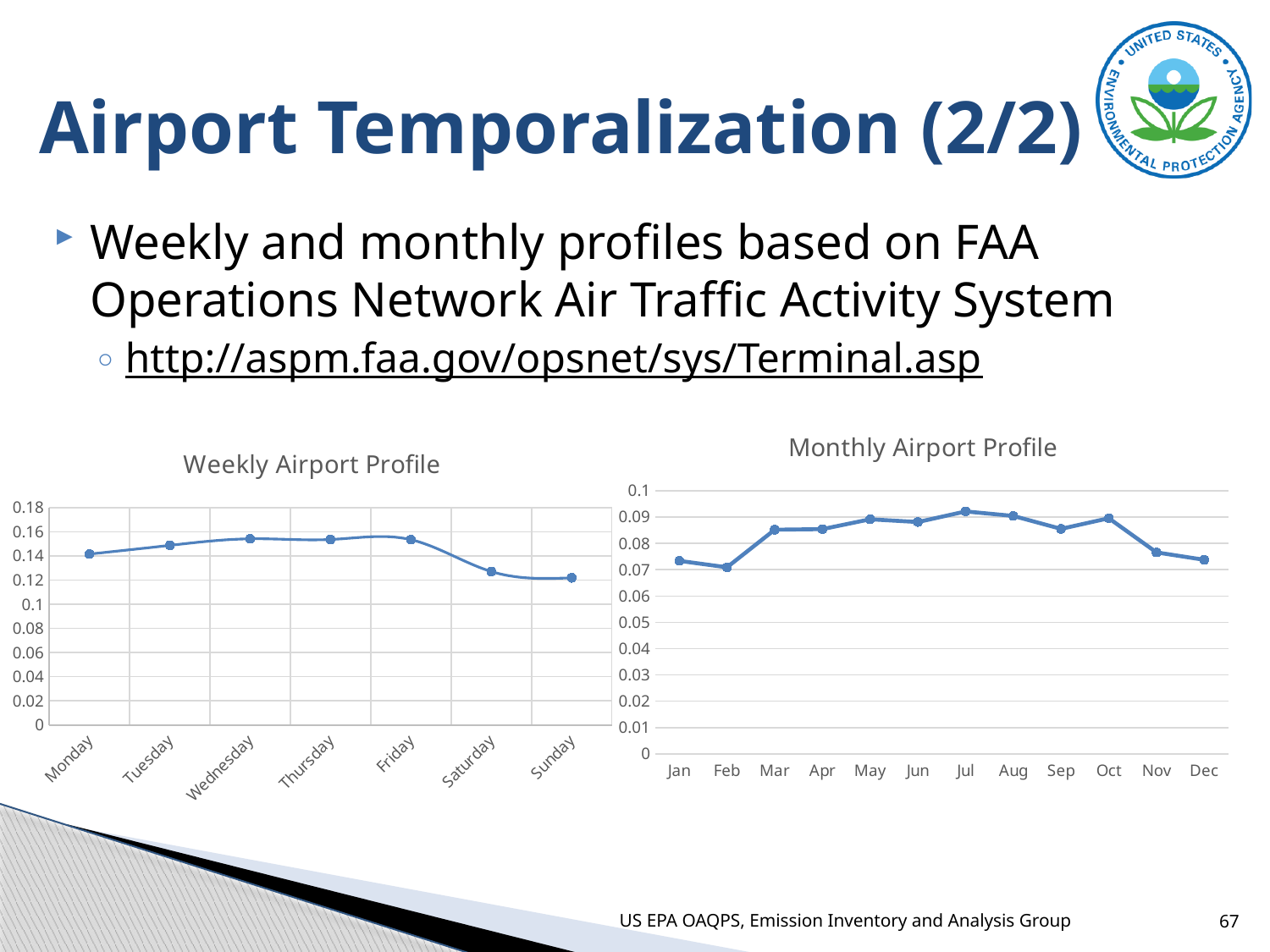
In the Weekly Airport Profile chart, how many days are plotted on the x axis? 7 In the Monthly Airport Profile chart, which is larger, the value for Jul or the value for Feb? Jul In the Monthly Airport Profile chart, which month has the lowest value? Feb What type of chart is the Weekly Airport Profile? line chart In the Monthly Airport Profile chart, is the value for Feb greater or less than 0.08? less In the Weekly Airport Profile chart, is the value for Sunday greater or less than 0.14? less What type of chart is the Monthly Airport Profile? line chart In the Weekly Airport Profile chart, do the values rise or fall from Friday to Sunday? fall In the Weekly Airport Profile chart, is the value for Wednesday greater or less than 0.14? greater In the Monthly Airport Profile chart, how many months are plotted on the x axis? 12 In the Weekly Airport Profile chart, which is larger, the value for Wednesday or the value for Sunday? Wednesday